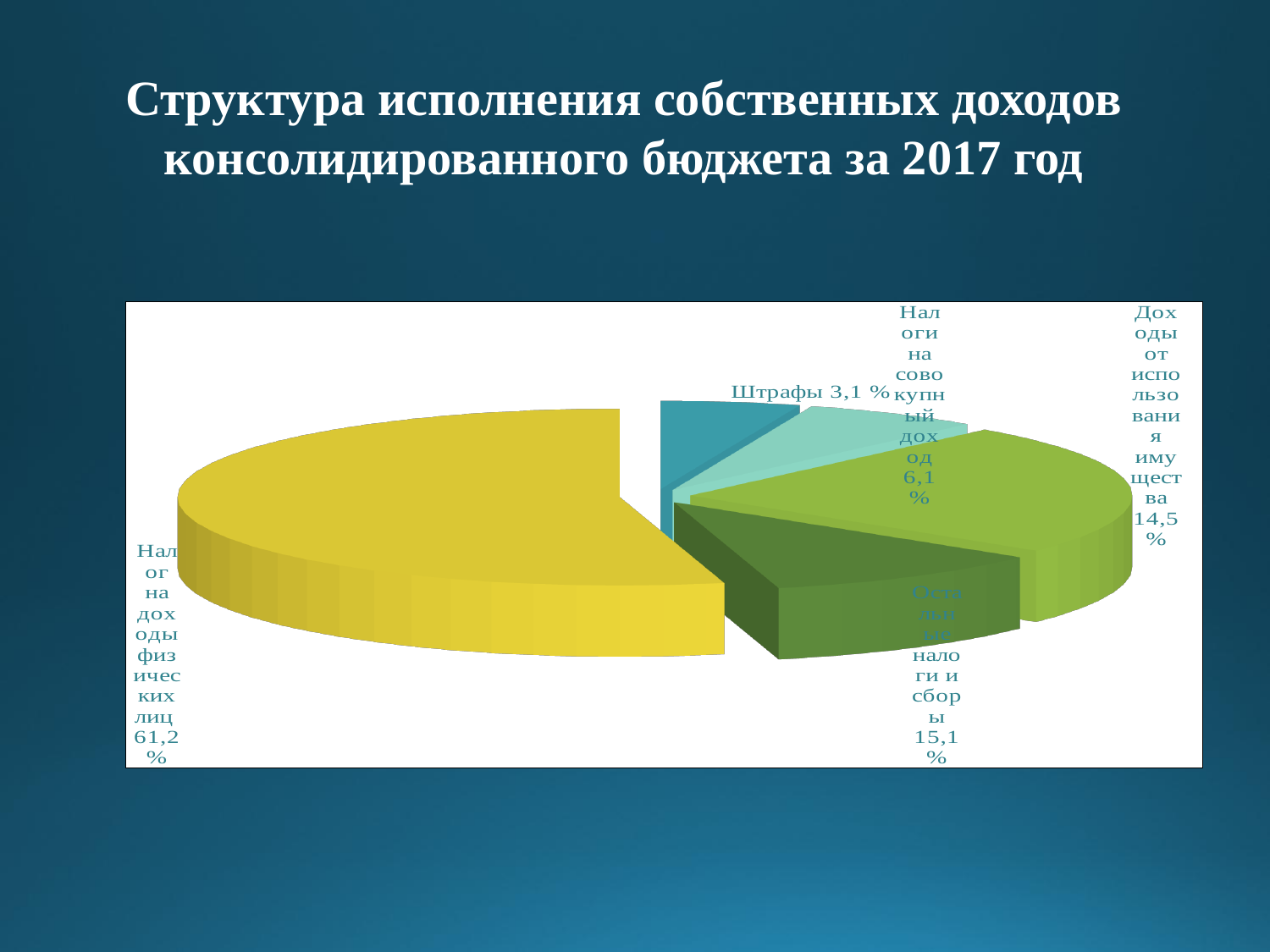
Which is larger: the share for Налоги на совокупный доход or the share for Штрафы? Налоги на совокупный доход Which category has the largest slice of the pie? Налог на доходы физических лиц How many slices does the pie chart have? 5 What is the title of the slide containing the chart? Структура исполнения собственных доходов консолидированного бюджета за 2017 год Which category has the smallest slice of the pie? Штрафы What share is shown for Штрафы? 3,1 % What share is shown for Доходы от использования имущества? 14,5 % What share of the pie is labelled for Налог на доходы физических лиц? 61,2 % What share is shown for Остальные налоги и сборы? 15,1 % What is the difference in percentage points between Налог на доходы физических лиц and Остальные налоги и сборы? 46,1 What share is shown for Налоги на совокупный доход? 6,1 % What kind of chart is shown on the slide? Pie chart